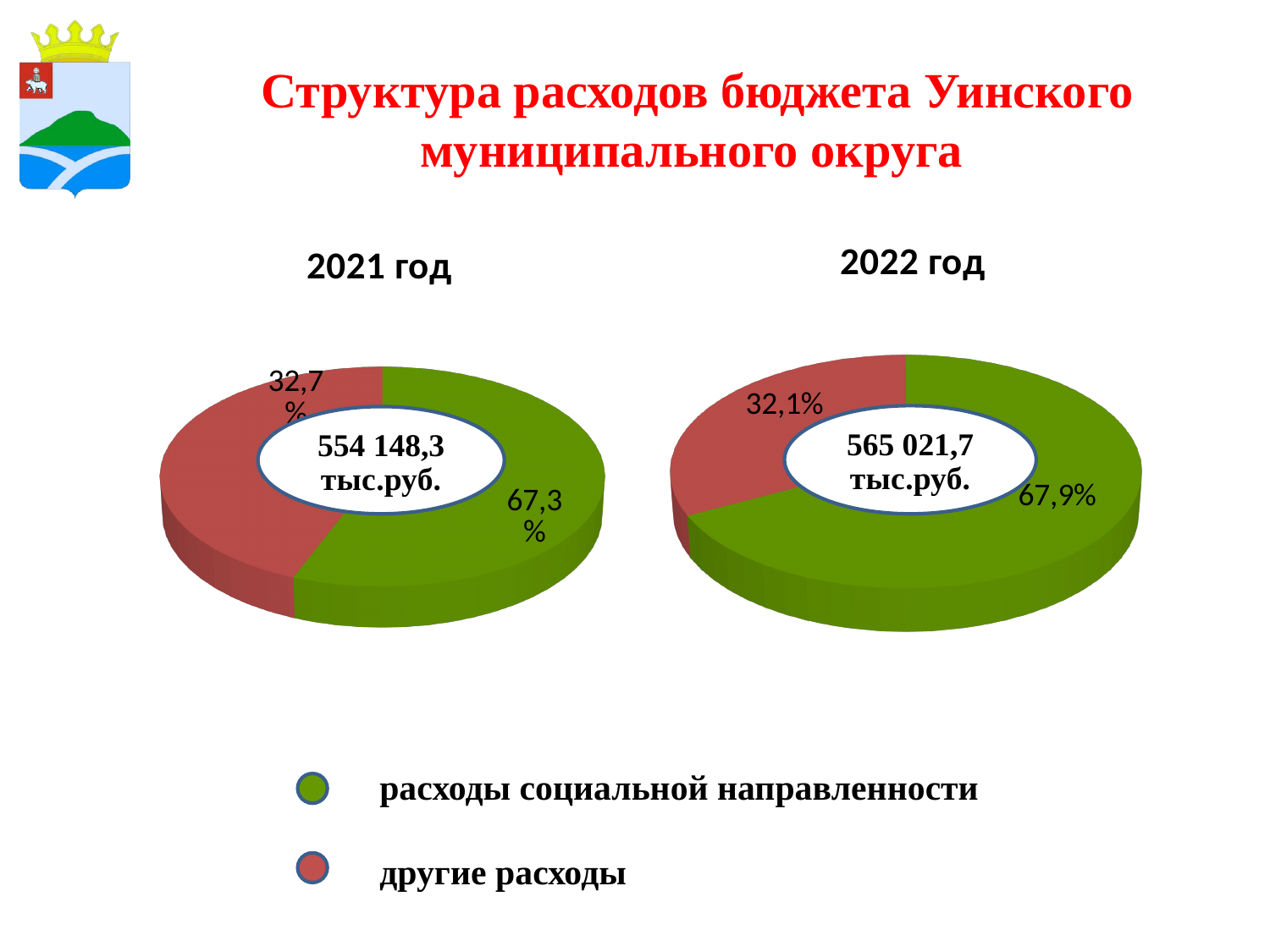
What total amount is shown in the centre of the 2021 год chart? 554 148,3 тыс.руб. How many categories does the legend list? 2 In the 2021 год chart, which category has the smallest share? другие расходы In the 2022 год chart, what share of expenditures is расходы социальной направленности? 67,9% In the 2021 год chart, what share of expenditures is другие расходы? 32,7% In the 2022 год chart, which category has the largest share? расходы социальной направленности Which year has the larger share of расходы социальной направленности, 2021 or 2022? 2022 In the 2021 год chart, what is the difference between the share of расходы социальной направленности and другие расходы? 34,6% In the 2022 год chart, what share of expenditures is другие расходы? 32,1% In the 2021 год chart, what share of expenditures is расходы социальной направленности? 67,3% What kind of chart is used for the 2021 год data? Pie chart What total amount is shown in the centre of the 2022 год chart? 565 021,7 тыс.руб.